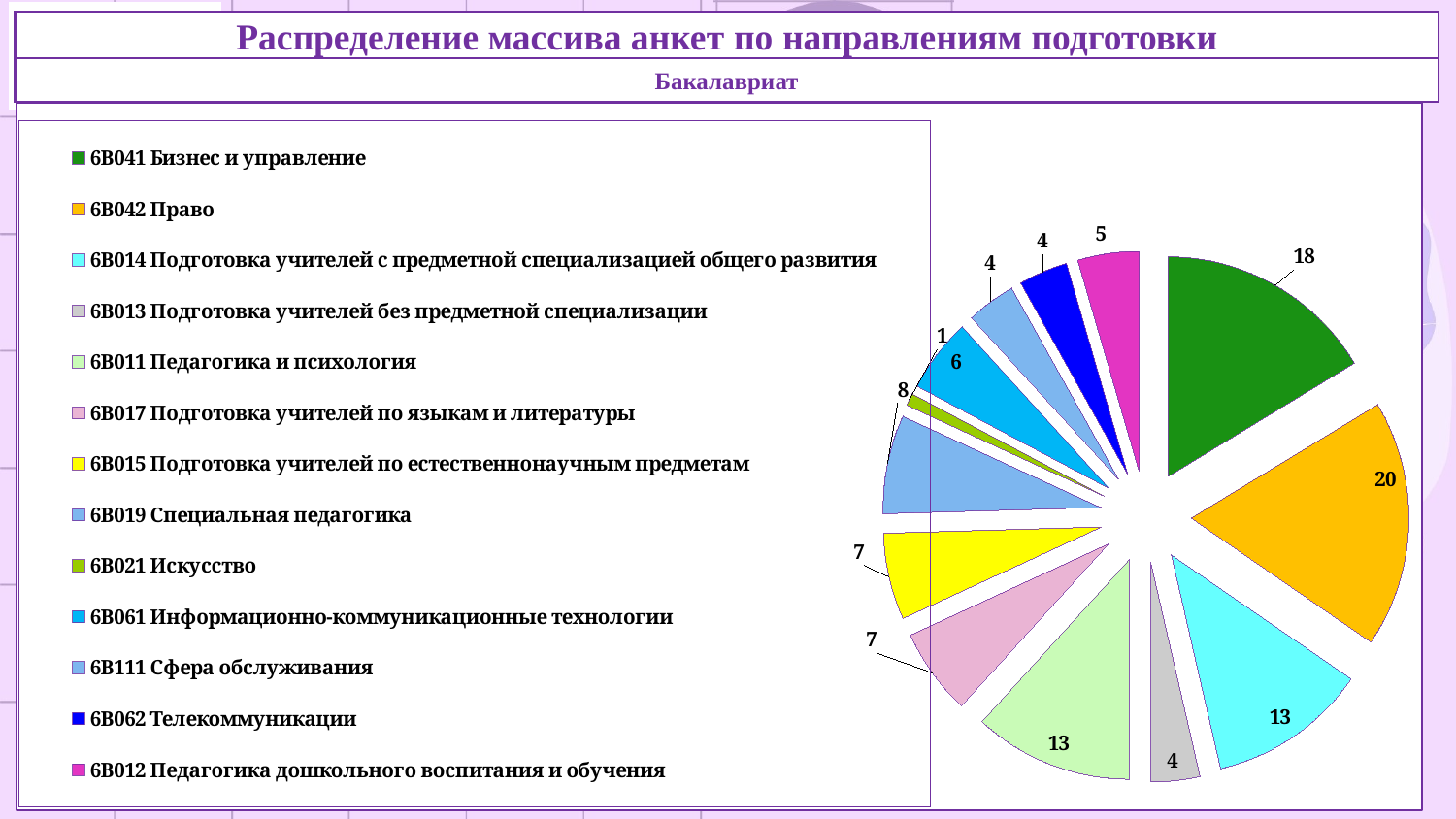
How many categories does the pie chart have? 13 What is the value for 6B041 Бизнес и управление? 18 What is the value for 6B019 Специальная педагогика? 8 What is the value for 6B042 Право? 20 Which is larger, the value for 6B014 Подготовка учителей с предметной специализацией общего развития or the value for 6B019 Специальная педагогика? 6B014 Подготовка учителей с предметной специализацией общего развития Which category has the largest slice of the pie? 6B042 Право What is the subtitle shown below the chart title? Бакалавриат What kind of chart is shown on the slide? pie chart What is the difference between the values for 6B042 Право and 6B041 Бизнес и управление? 2 What is the value for 6B061 Информационно-коммуникационные технологии? 6 What is the difference between the values for 6B012 Педагогика дошкольного воспитания и обучения and 6B021 Искусство? 4 Which category has the smallest slice of the pie? 6B021 Искусство